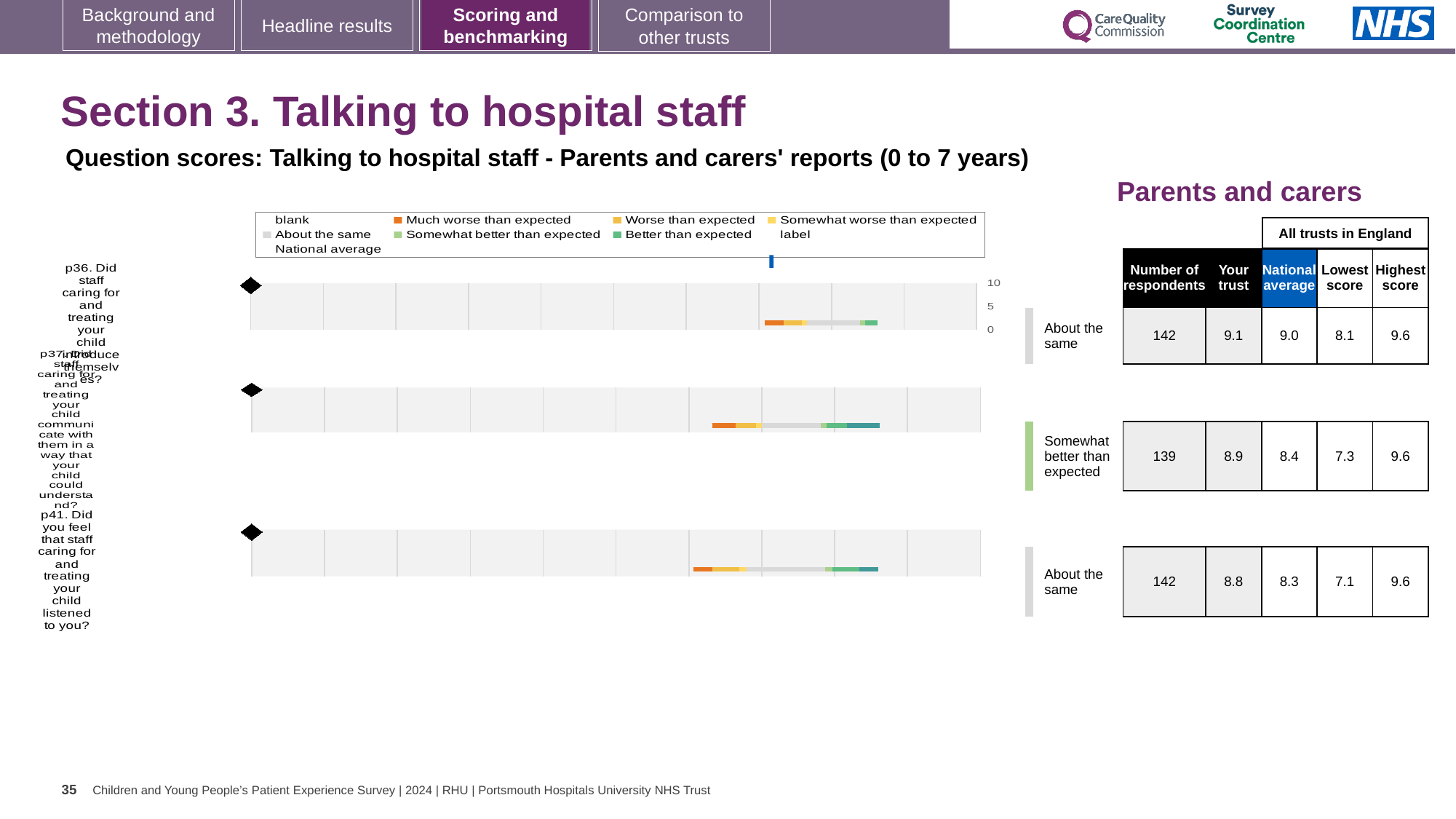
For the second chart (p37), which is larger: the 'Your trust' score or the national average? Your trust In the legend, which colour represents 'Much worse than expected'? orange How many question charts (p36, p37, p41) are shown on the slide? 3 What is the maximum value shown on the score axis of the charts? 10 For the first chart (p36), what is the 'Your trust' score shown in the table? 9.1 For the first chart (p36), what is the difference between the 'Your trust' score and the national average? 0.1 Which of the three questions has the highest 'Your trust' score? p36 For the first chart (p36), what is the highest score among all trusts in England? 9.6 For the second chart (p37), what is the number of respondents shown in the table? 139 For the third chart (p41), what is the national average score shown in the table? 8.3 What kind of chart is used to show the question scores on this slide? bar chart For the second chart (p37), what is the lowest score among all trusts in England? 7.3